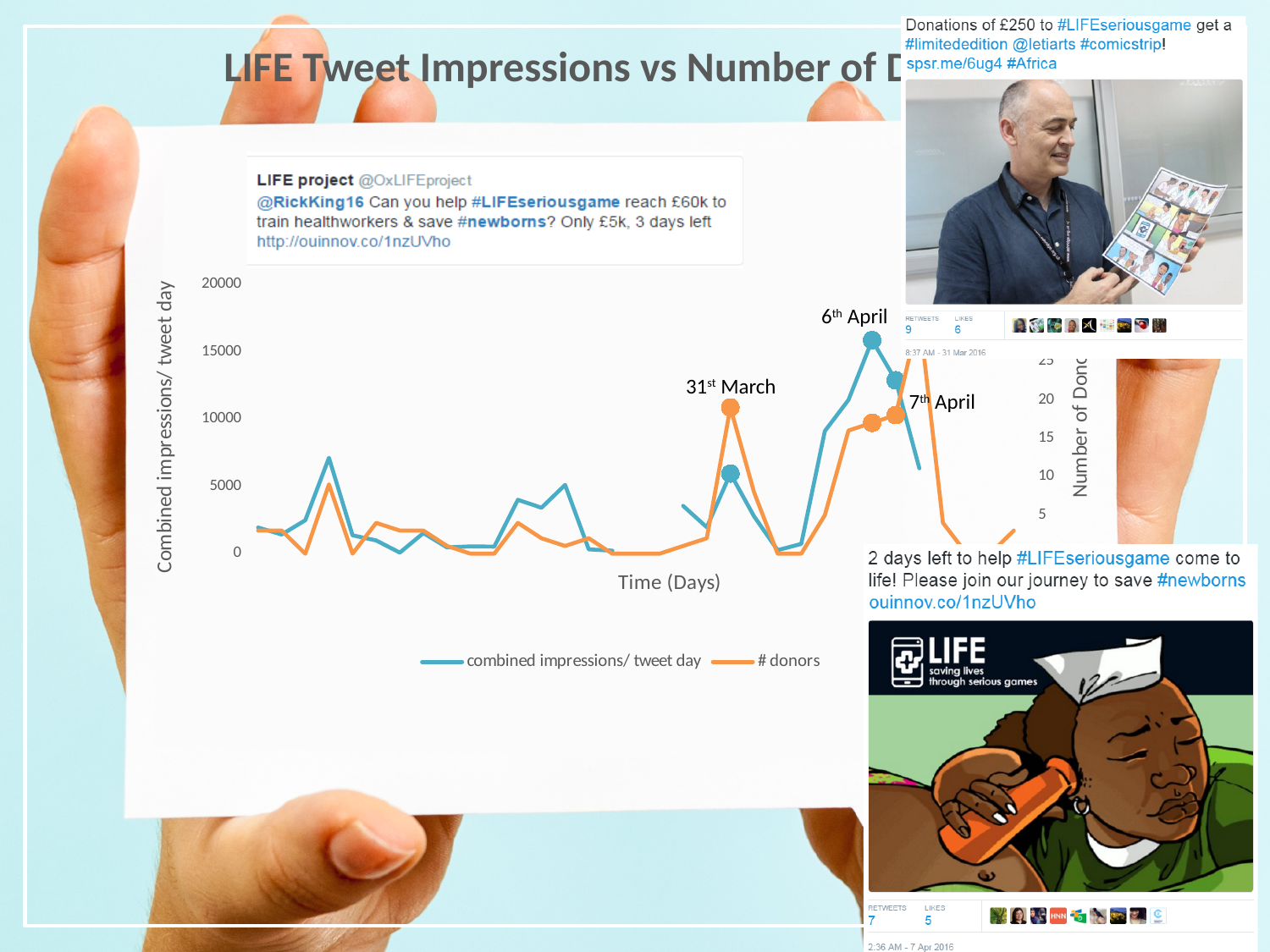
Is the combined impressions/ tweet day value on 7th April greater or less than 10000? greater Of the three annotated dates, which has the highest combined impressions/ tweet day value? 6th April What are the two series named in the chart's legend? combined impressions/ tweet day and # donors What kind of chart is shown on the slide? line chart Is the combined impressions/ tweet day value on 6th April greater or less than 15000? greater Which has the higher combined impressions/ tweet day value, 31st March or 7th April? 7th April Which has the higher combined impressions/ tweet day value, 31st March or 6th April? 6th April Is the combined impressions/ tweet day value on 6th April greater or less than 20000? less What is the title of the chart's x axis? Time (Days) How many series does the chart's legend list? 2